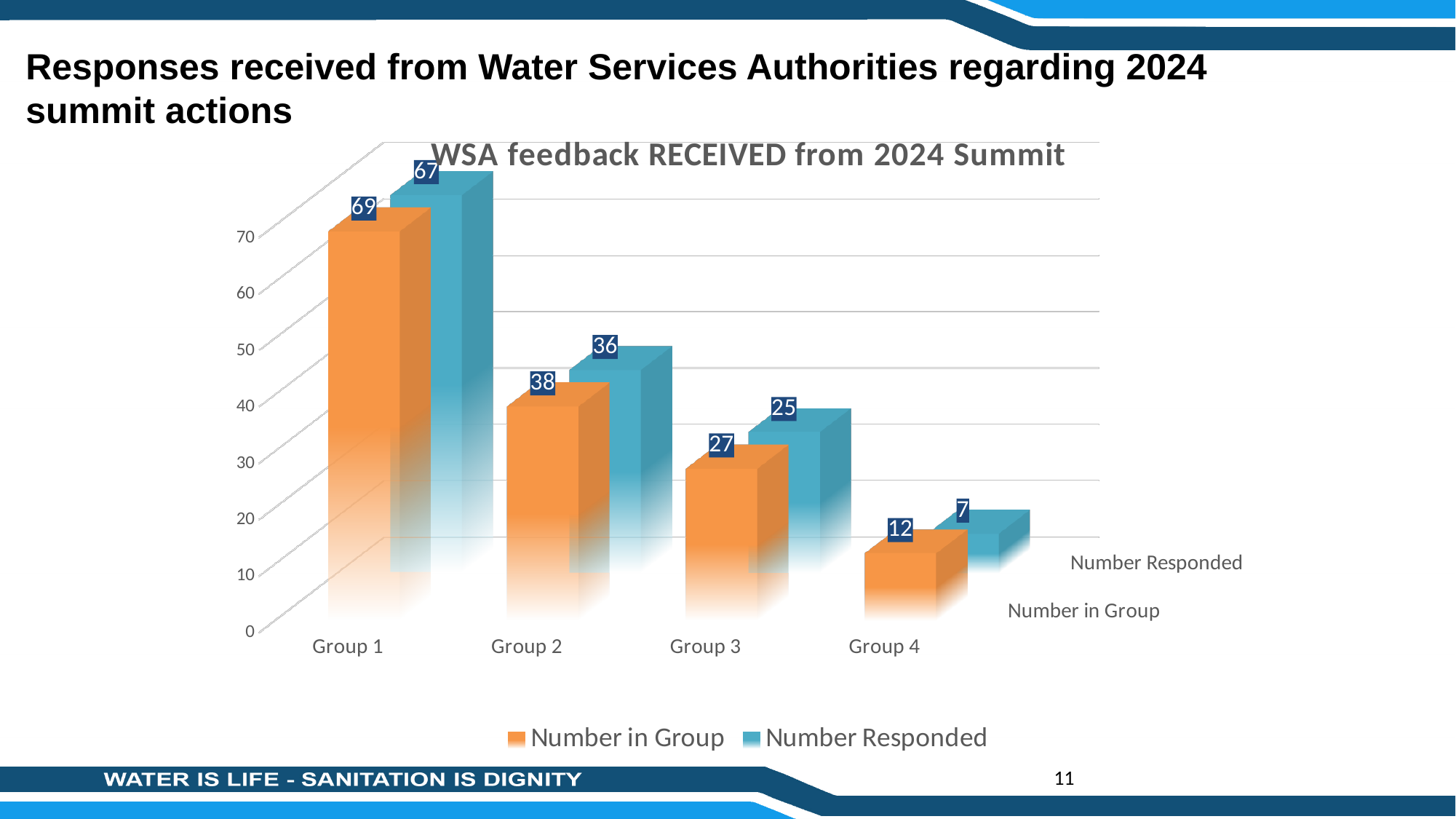
What kind of chart is shown? Bar chart Do the Number in Group values rise or fall from Group 1 to Group 4? Fall How many series does the legend list? 2 Which is larger for Group 2: Number in Group or Number Responded? Number in Group What is the Number Responded for Group 4? 7 What is the difference between Number in Group and Number Responded for Group 3? 2 What is the Number Responded for Group 2? 36 What is the Number in Group for Group 1? 69 What is the title of the chart? WSA feedback RECEIVED from 2024 Summit Which group has the highest Number in Group? Group 1 Which group has the lowest Number Responded? Group 4 How many groups are shown on the x axis? 4